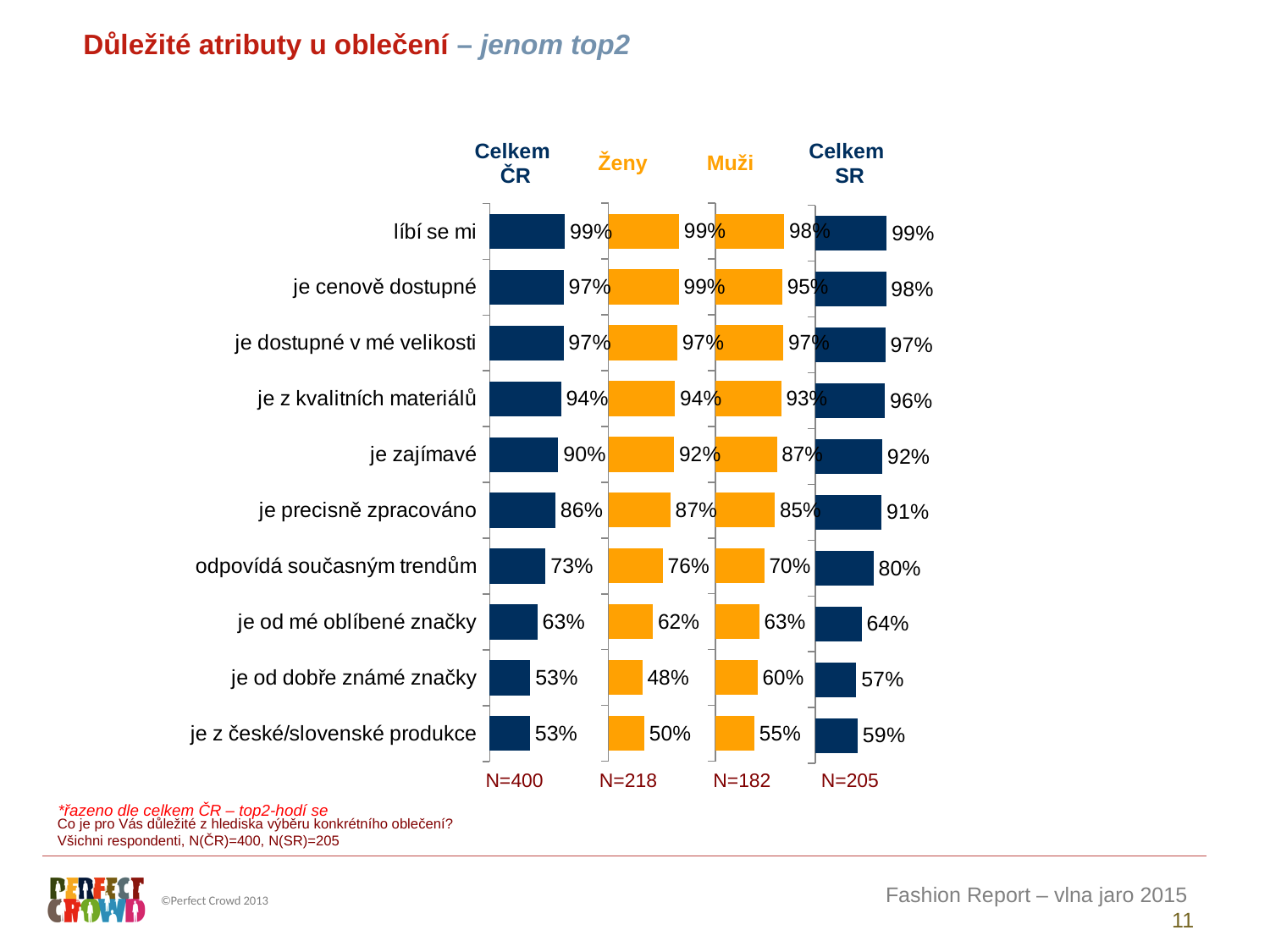
How many categories are shown in the Celkem ČR chart? 10 For "je precisně zpracováno", which is larger: the Celkem ČR value or the Celkem SR value? Celkem SR What type of chart is used for the Ženy data? bar chart In the Celkem SR chart, which category has the lowest value? je od dobře známé značky In the Muži chart, what is the value for "je zajímavé"? 87% In the Ženy chart, which category has the lowest value? je od dobře známé značky For "je od dobře známé značky", which is larger: the Ženy value or the Muži value? Muži In the Celkem SR chart, what is the value for "je z české/slovenské produkce"? 59% In the Celkem ČR chart, what is the value for "odpovídá současným trendům"? 73% What is the sample size (N) shown under the Muži chart? N=182 In the Ženy chart, what is the value for "je od dobře známé značky"? 48% In the Muži chart, what is the difference between "líbí se mi" and "je z české/slovenské produkce"? 43%